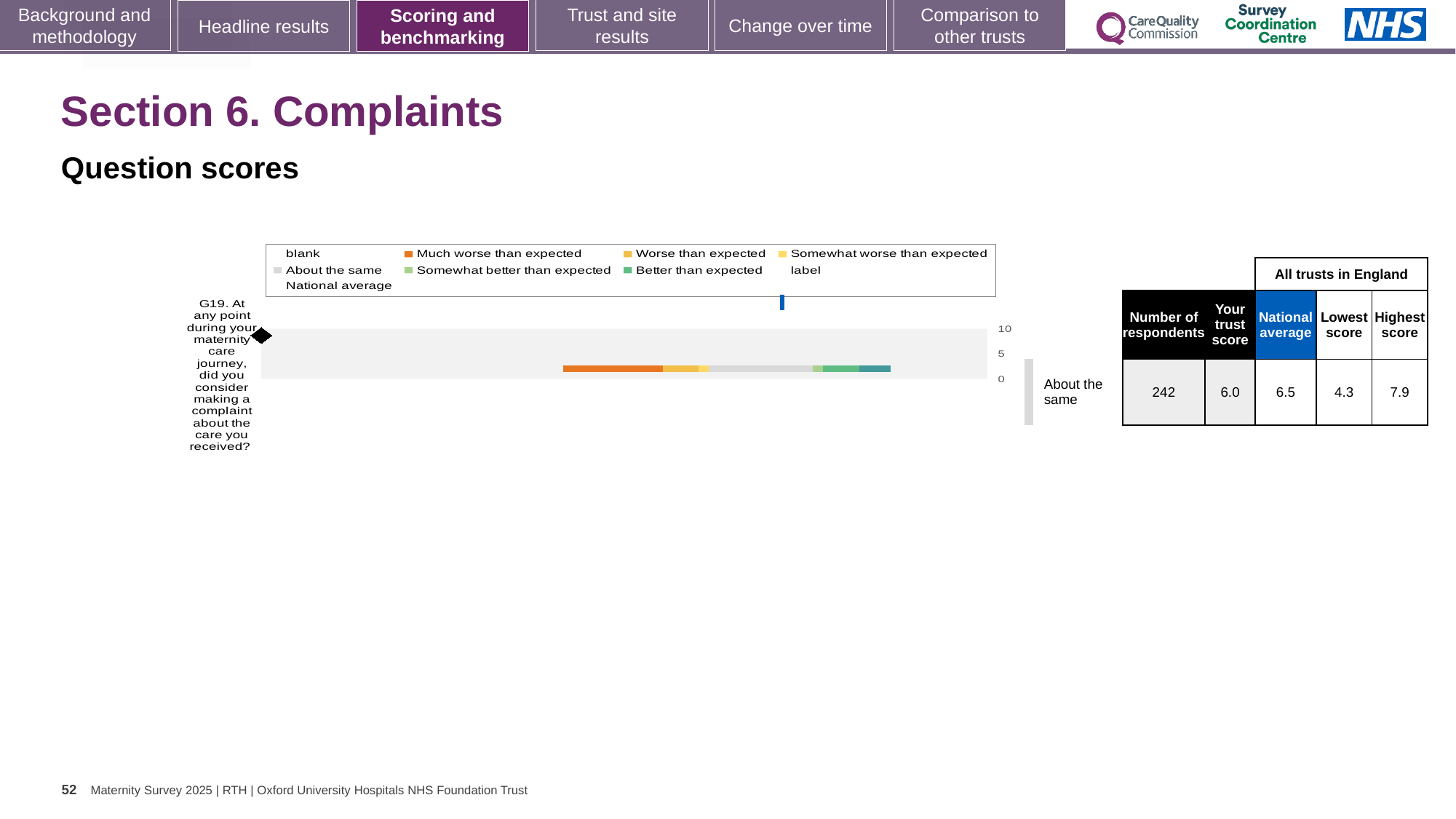
In the table beside the chart, what is the number of respondents for question G19? 242 In the table beside the chart, what is the lowest score among all trusts in England for question G19? 4.3 How many survey questions are plotted as bars in the chart? 1 For question G19, what is the difference between the highest score and the lowest score among all trusts in England? 3.6 In the table beside the chart, what is the trust's score for question G19? 6.0 For question G19, which is larger: the trust's score or the national average? National average What benchmark category is shown next to the chart for question G19? About the same How many entries does the chart's legend list? 9 In the table beside the chart, what is the national average score for question G19? 6.5 What kind of chart is shown on the slide for question G19? bar chart In the table beside the chart, what is the highest score among all trusts in England for question G19? 7.9 Which survey question is plotted in the chart? G19. At any point during your maternity care journey, did you consider making a complaint about the care you received?